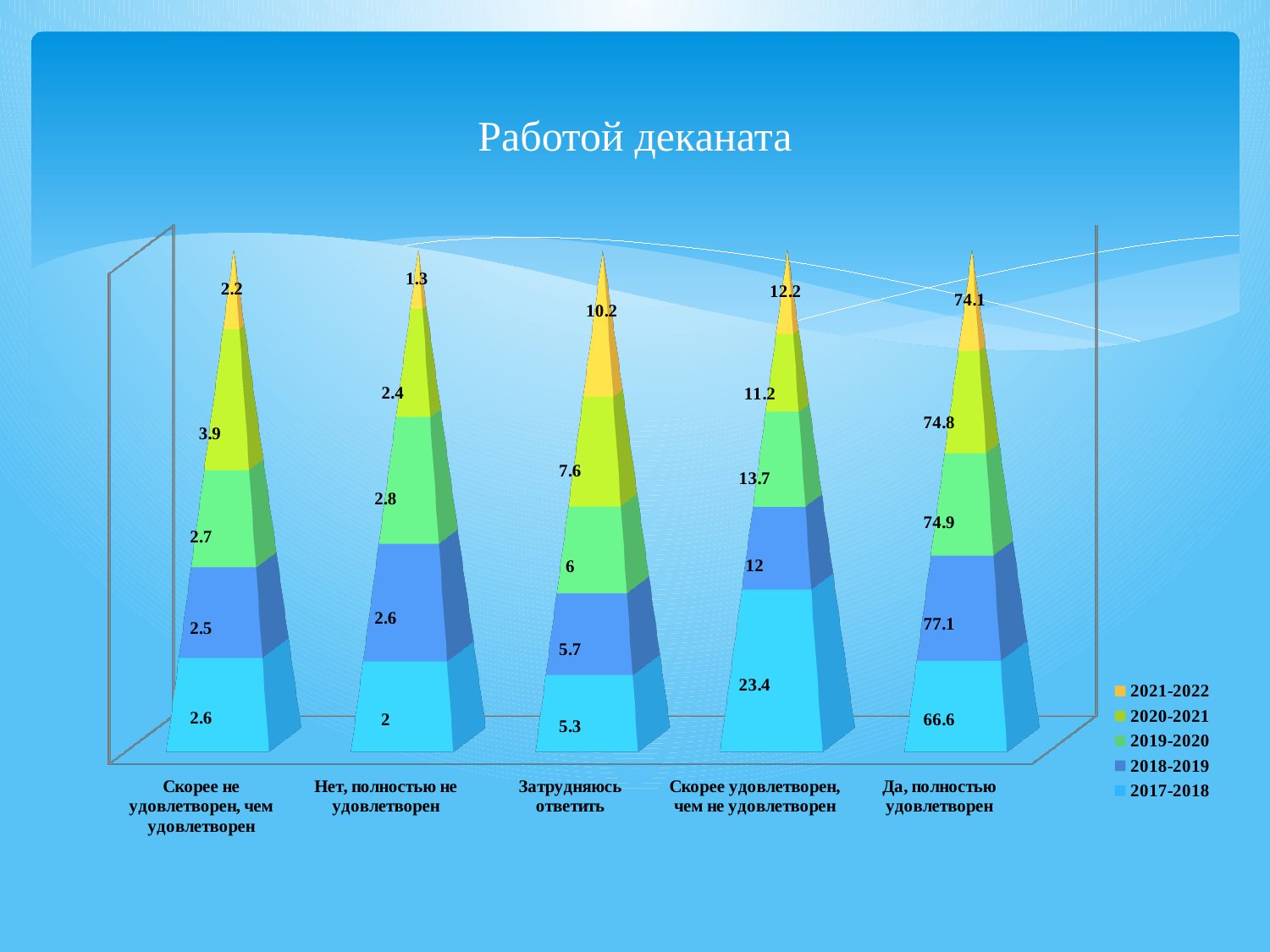
How many categories are shown on the x axis? 5 How many series does the legend list? 5 In the 'Скорее удовлетворен, чем не удовлетворен' category, which is larger: the 2017-2018 value or the 2019-2020 value? 2017-2018 What is the value for 2020-2021 in the 'Нет, полностью не удовлетворен' category? 2.4 What is the value for 2017-2018 in the 'Да, полностью удовлетворен' category? 66.6 What kind of chart is shown on the slide? Stacked bar chart What is the difference between the 2018-2019 and 2017-2018 values in the 'Да, полностью удовлетворен' category? 10.5 What is the value for 2021-2022 in the 'Затрудняюсь ответить' category? 10.2 Which category has the lowest value for the 2021-2022 series? Нет, полностью не удовлетворен What is the title of the chart? Работой деканата What is the value for 2018-2019 in the 'Скорее удовлетворен, чем не удовлетворен' category? 12 Which category has the highest value for the 2021-2022 series? Да, полностью удовлетворен